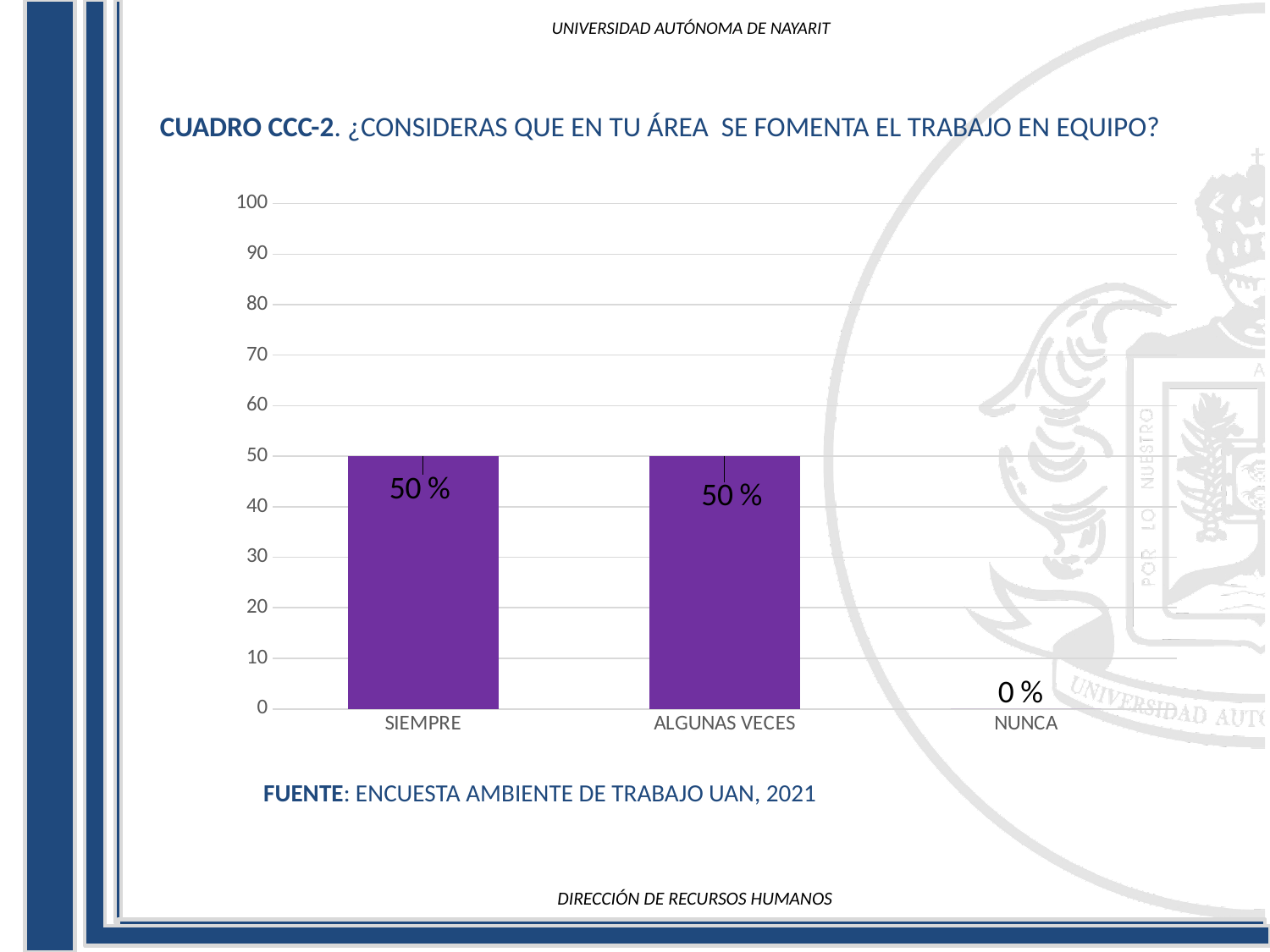
What kind of chart is shown on the slide? bar chart What is the difference between the values for SIEMPRE and NUNCA? 50 % What is the source cited below the chart? ENCUESTA AMBIENTE DE TRABAJO UAN, 2021 What is the value for SIEMPRE? 50 % What is the value for NUNCA? 0 % Is the value for SIEMPRE greater or less than 60? less Which category has the lowest value? NUNCA What is the highest value shown on the vertical axis? 100 How many categories are shown on the x axis? 3 Which is larger, the value for ALGUNAS VECES or the value for NUNCA? ALGUNAS VECES What is the value for ALGUNAS VECES? 50 %